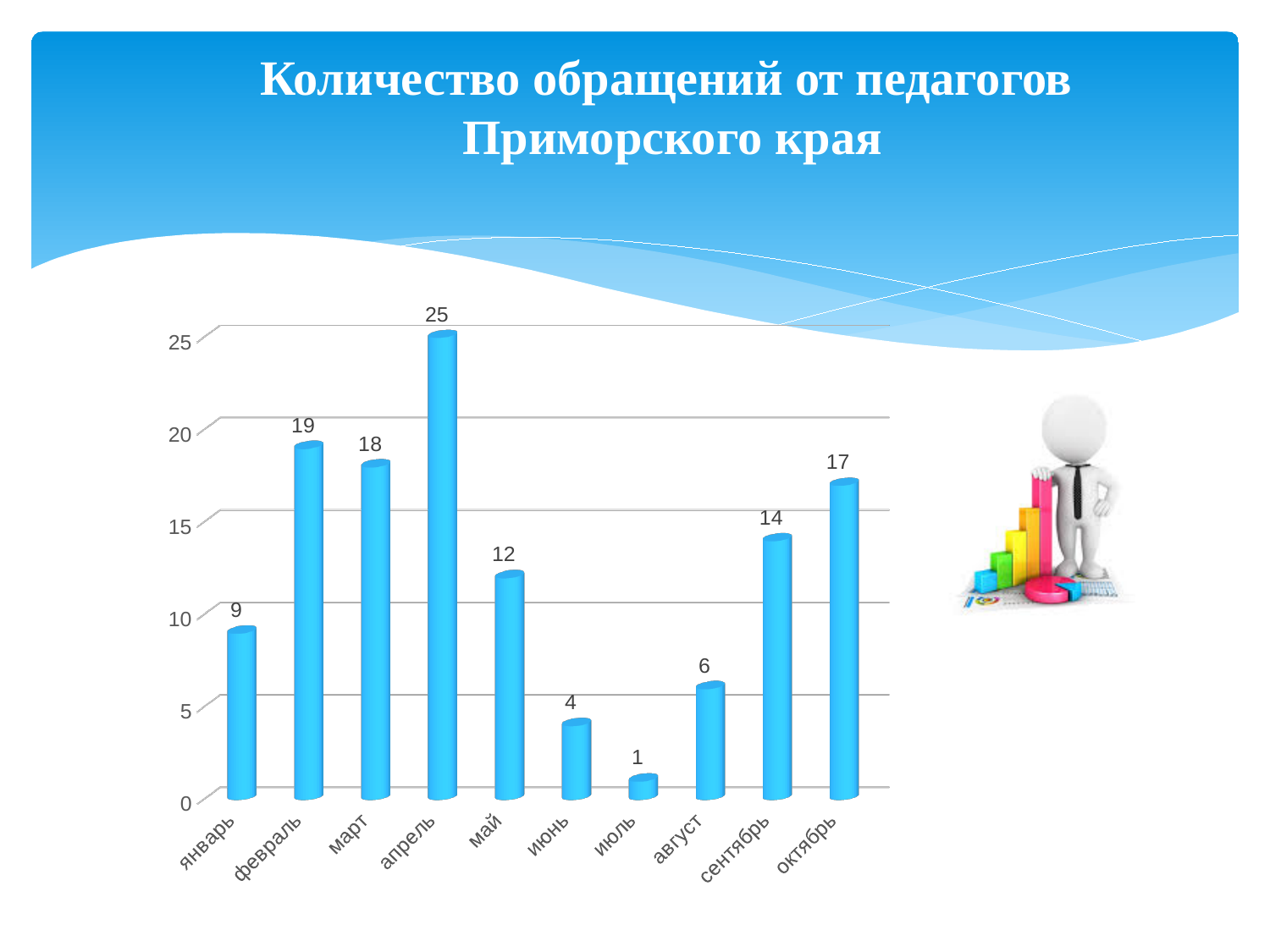
Is the value for январь greater or less than 10? less How many months are shown on the x axis? 10 What is the difference between the values for февраль and март? 1 Which month has the highest value? апрель What is the value for сентябрь? 14 What is the title of the slide? Количество обращений от педагогов Приморского края Which is larger, the value for октябрь or the value for сентябрь? октябрь What is the value for июль? 1 What is the value for апрель? 25 What is the difference between the values for апрель and май? 13 Which month has the lowest value? июль What kind of chart is shown on the slide? bar chart